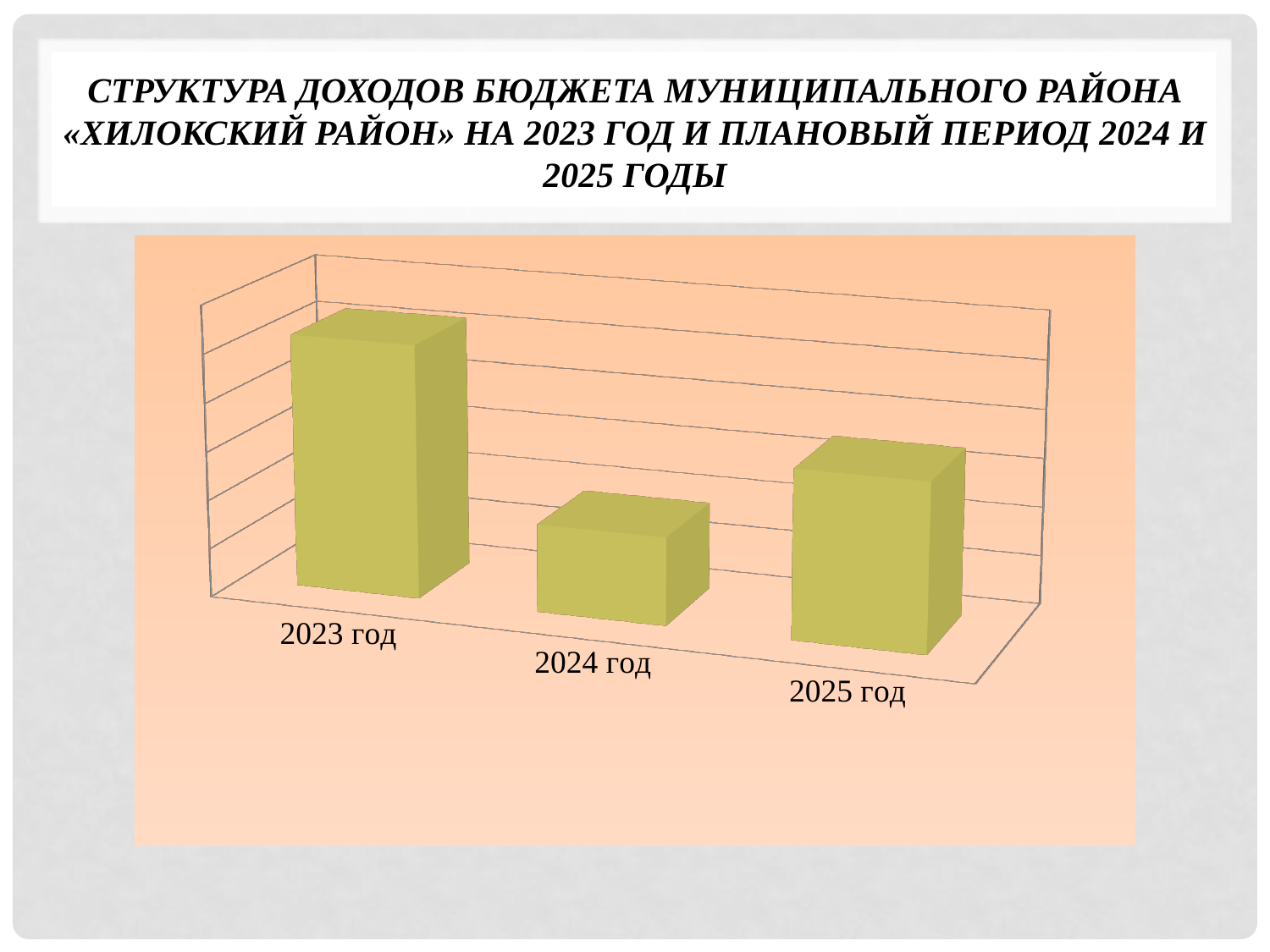
What kind of chart is shown on the slide? bar chart Do the bar values rise or fall from 2024 год to 2025 год? rise Which bar is shorter, 2023 год or 2024 год? 2024 год Which year has the lowest bar on the chart? 2024 год Which bar is taller, 2024 год or 2025 год? 2025 год What colour are the bars on the chart? olive green What are the category labels along the x axis of the chart? 2023 год, 2024 год, 2025 год How many categories are plotted on the chart? 3 Which bar is taller, 2023 год or 2025 год? 2023 год Do the bar values rise or fall from 2023 год to 2024 год? fall Which year has the highest bar on the chart? 2023 год